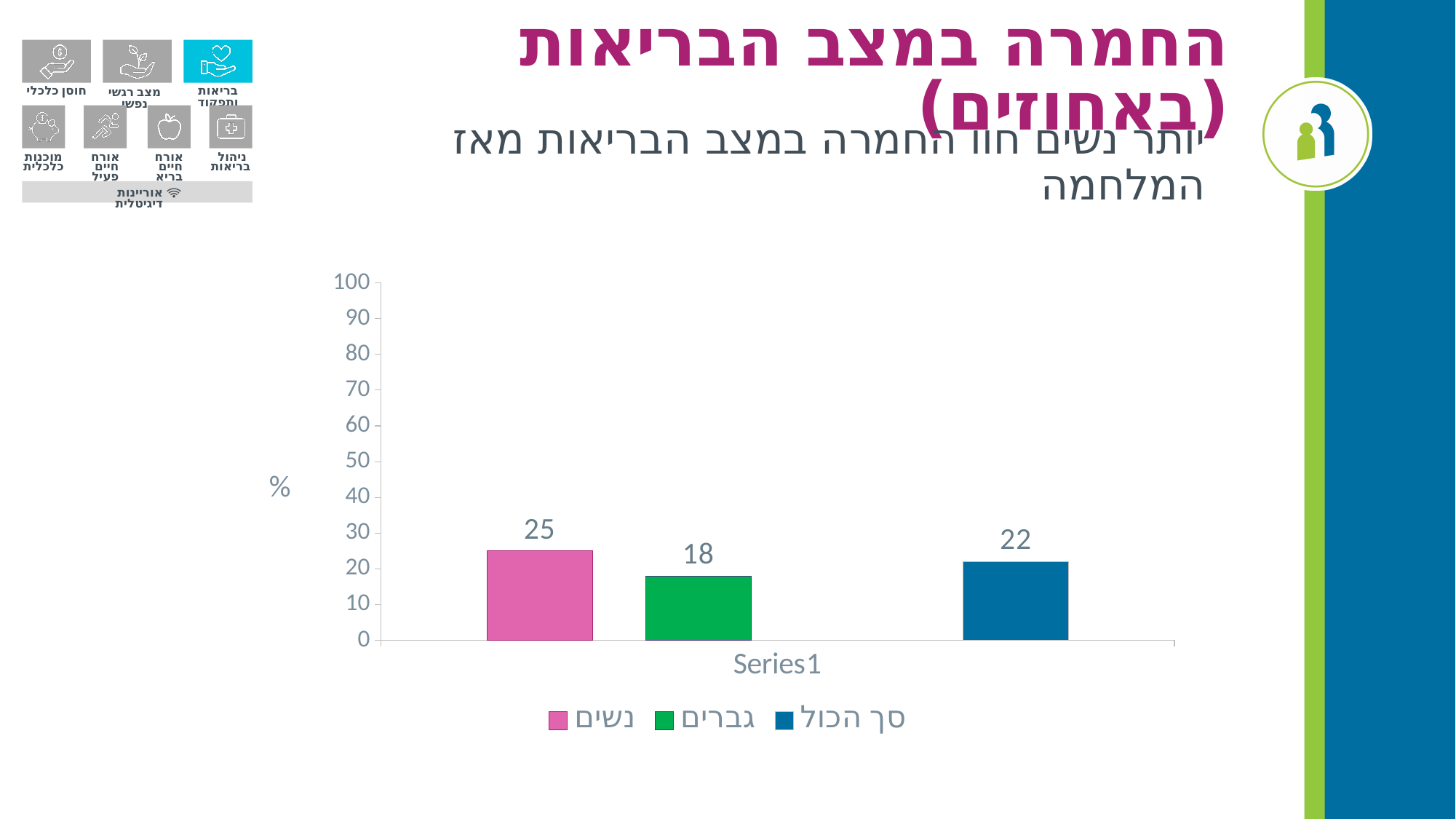
What is the value for גברים (men) in the chart? 18 Which is larger, the value for גברים or the value for סך הכול? סך הכול What kind of chart is shown on the slide? bar chart What is the value for סך הכול (total) in the chart? 22 Which series has the lowest value in the chart? גברים Which series has the highest value in the chart? נשים What is the difference between the values for נשים and גברים? 7 What label is shown on the vertical axis of the chart? % What is the value for נשים (women) in the chart? 25 Is the value for נשים greater or less than 20? greater How many series does the legend list? 3 What is the difference between the values for נשים and סך הכול? 3